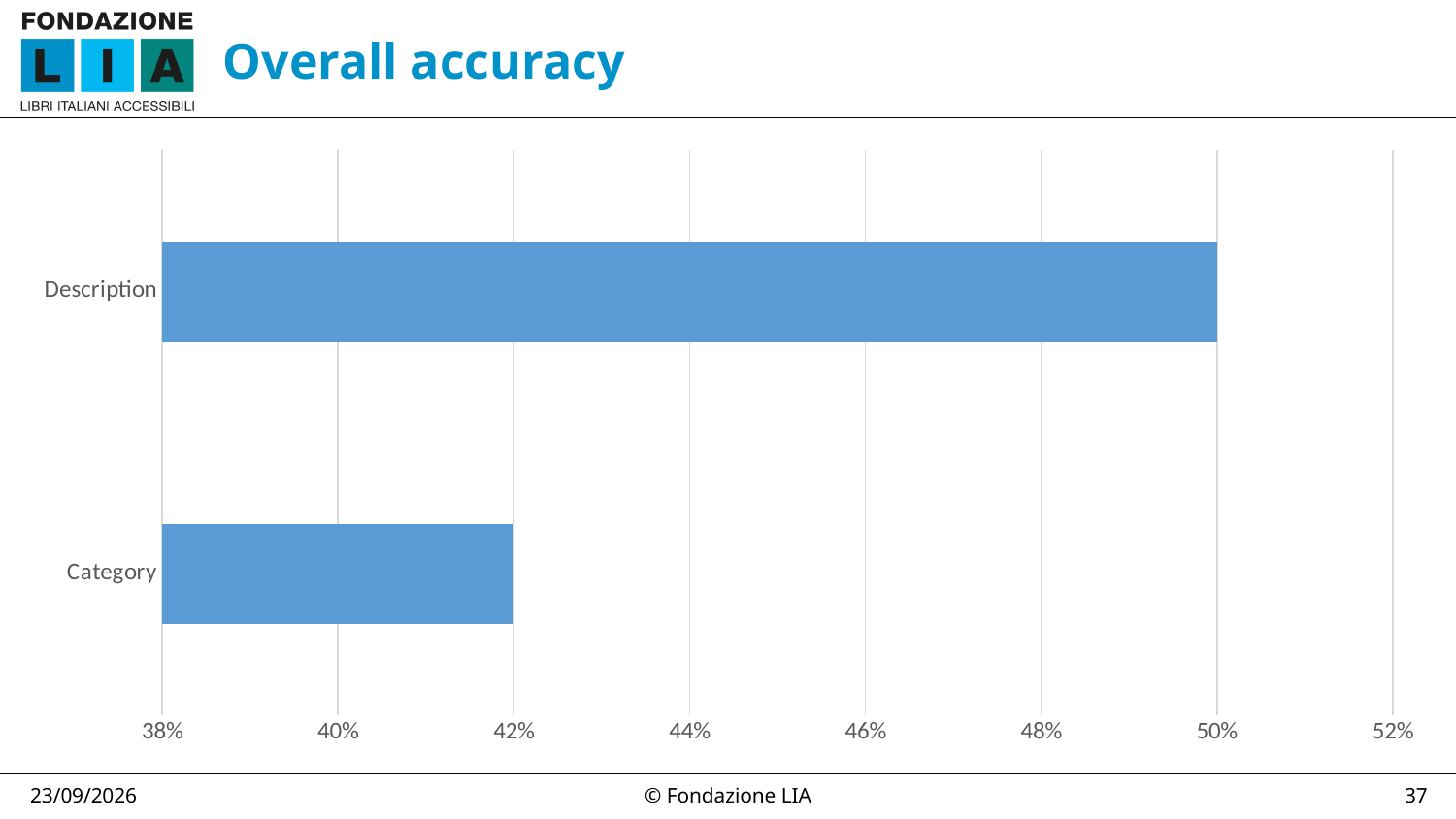
Is the value for Category greater or less than 44%? less What is the title of the slide containing the chart? Overall accuracy What is the value for Description? 50% What is the difference between the values for Description and Category? 8% What kind of chart is shown on the slide? bar chart Which category has the lowest value? Category Which is larger, the value for Description or the value for Category? Description What is the value for Category? 42% Is the value for Description greater or less than 46%? greater What is the lowest value shown on the horizontal axis? 38% Which category has the highest value? Description How many categories are shown in the chart? 2